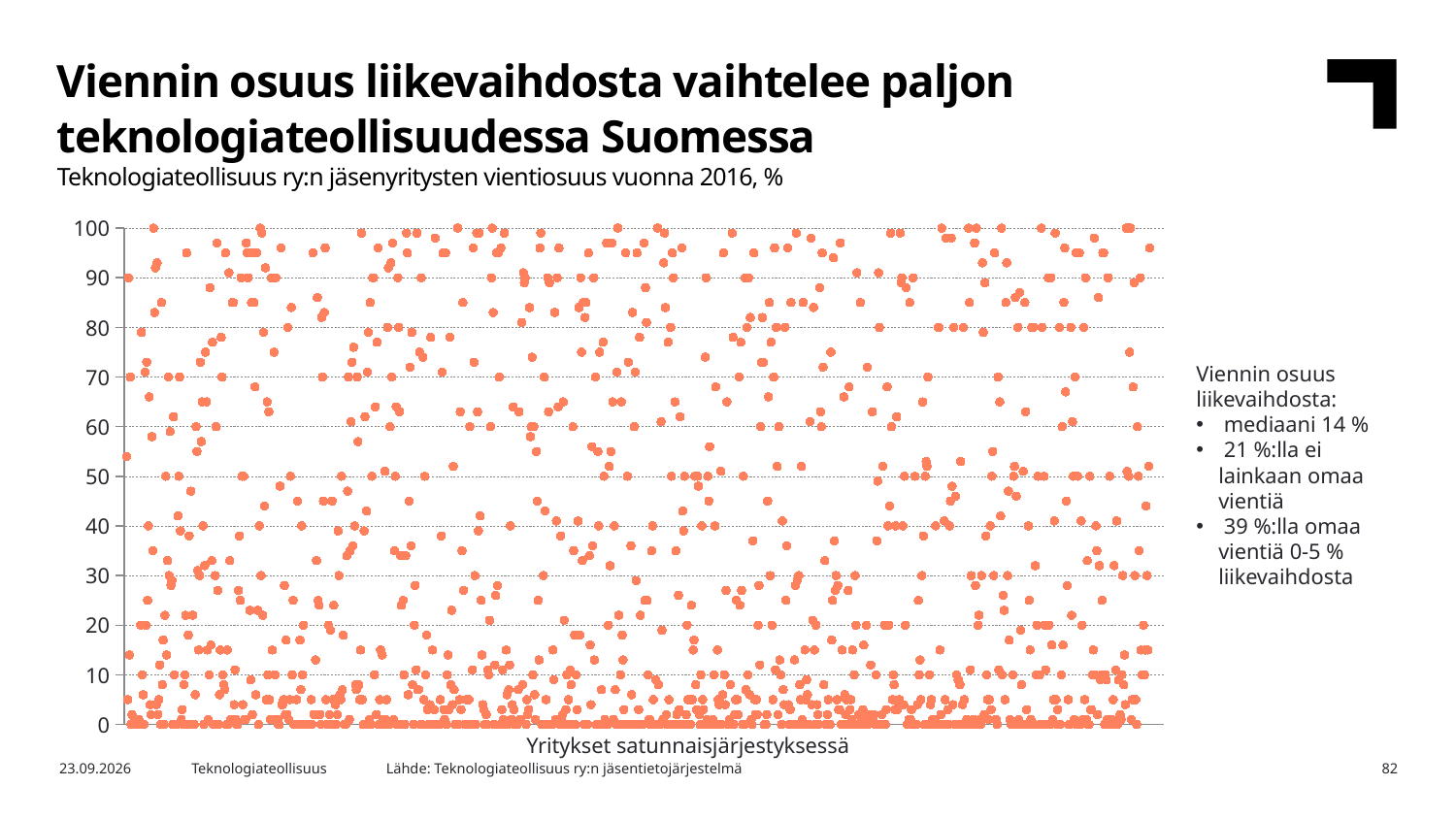
According to the text beside the chart, what is the median export share of turnover? 14 % What is the label on the x axis of the chart? Yritykset satunnaisjärjestyksessä What is the subtitle describing the chart's data? Teknologiateollisuus ry:n jäsenyritysten vientiosuus vuonna 2016, % Which year does the chart's data refer to? 2016 According to the text beside the chart, what share of companies have no exports at all? 21 % What kind of chart is shown on the slide? scatter plot According to the text beside the chart, what share of companies have exports of 0-5 % of turnover? 39 %